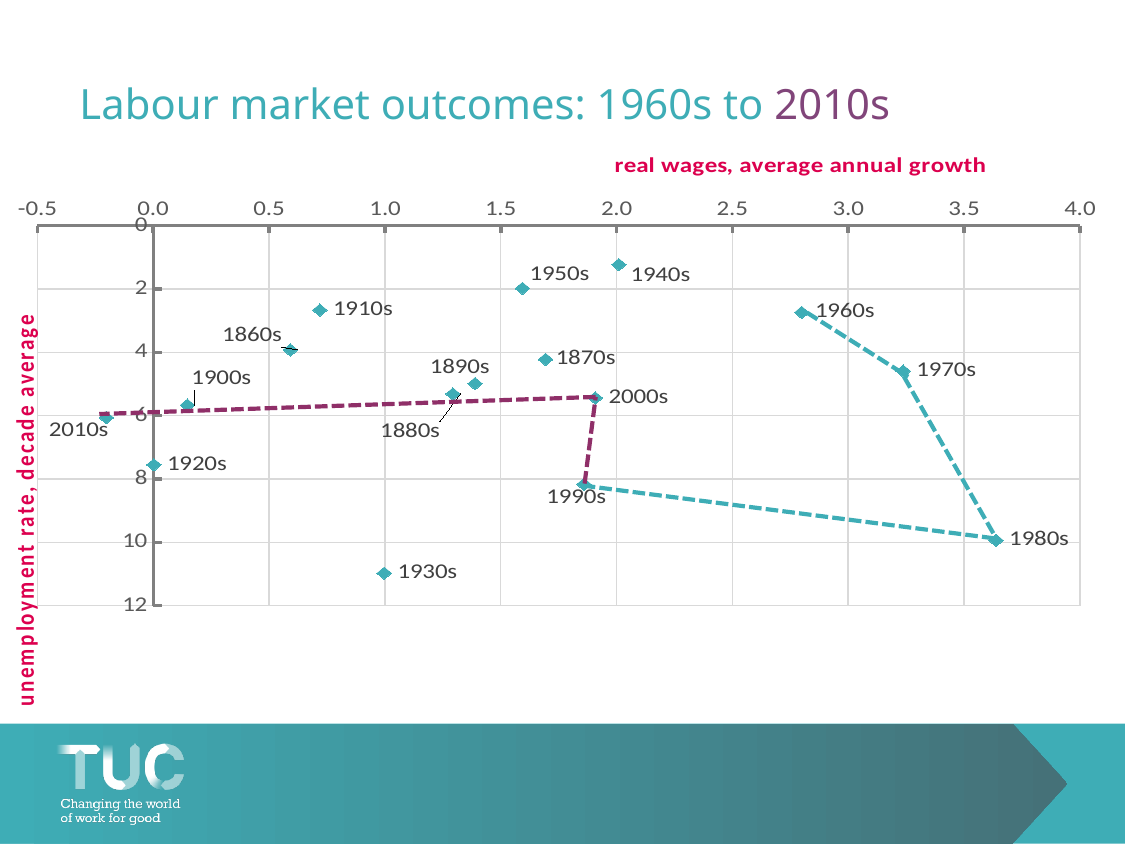
Is the unemployment rate for the 1930s greater or less than 10? greater Is the unemployment rate for the 1980s greater or less than 8? greater Which decade has the lowest unemployment rate? 1940s Is the real wages average annual growth for the 1960s greater or less than 2.5? greater How many decade points are plotted on the chart? 16 What kind of chart is shown on the slide? scatter chart What is the label of the vertical axis? unemployment rate, decade average Which decade has a higher unemployment rate, the 1990s or the 2000s? 1990s Which decade has the highest real wages average annual growth? 1980s Which decade has the highest unemployment rate? 1930s Which decade has higher real wages average annual growth, the 1960s or the 1970s? 1970s Which decade has the lowest real wages average annual growth? 2010s